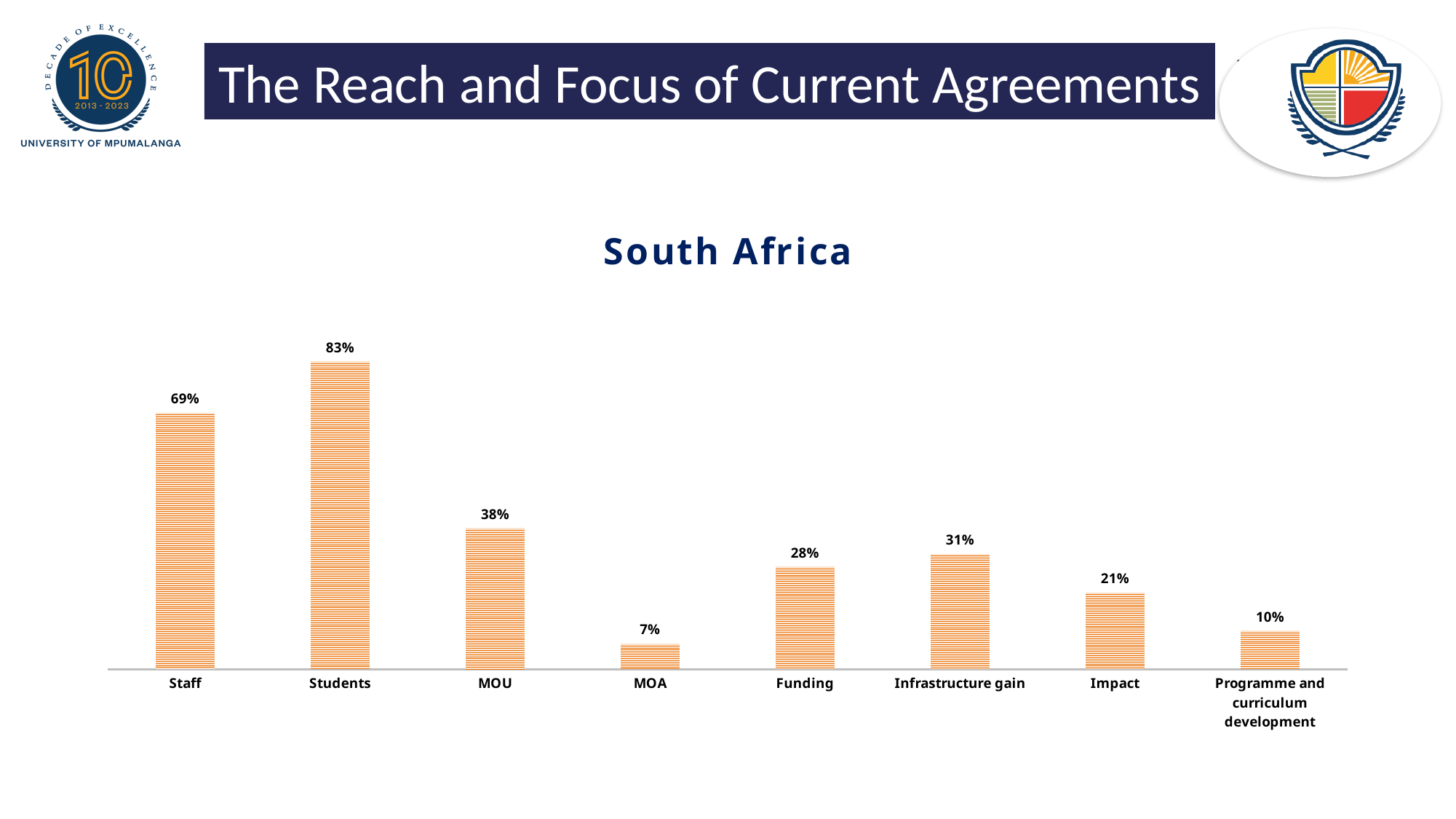
Which category has the highest value? Students What is the difference between the values for MOU and Funding? 10% What is the value for MOA? 7% How many categories are shown on the chart? 8 Which is larger, the value for Funding or the value for Impact? Funding What is the value for Students? 83% What is the title of the chart? South Africa What is the value for Infrastructure gain? 31% What is the value for Programme and curriculum development? 10% What is the difference between the values for Students and Staff? 14% What kind of chart is shown on the slide? Bar chart Which category has the lowest value? MOA